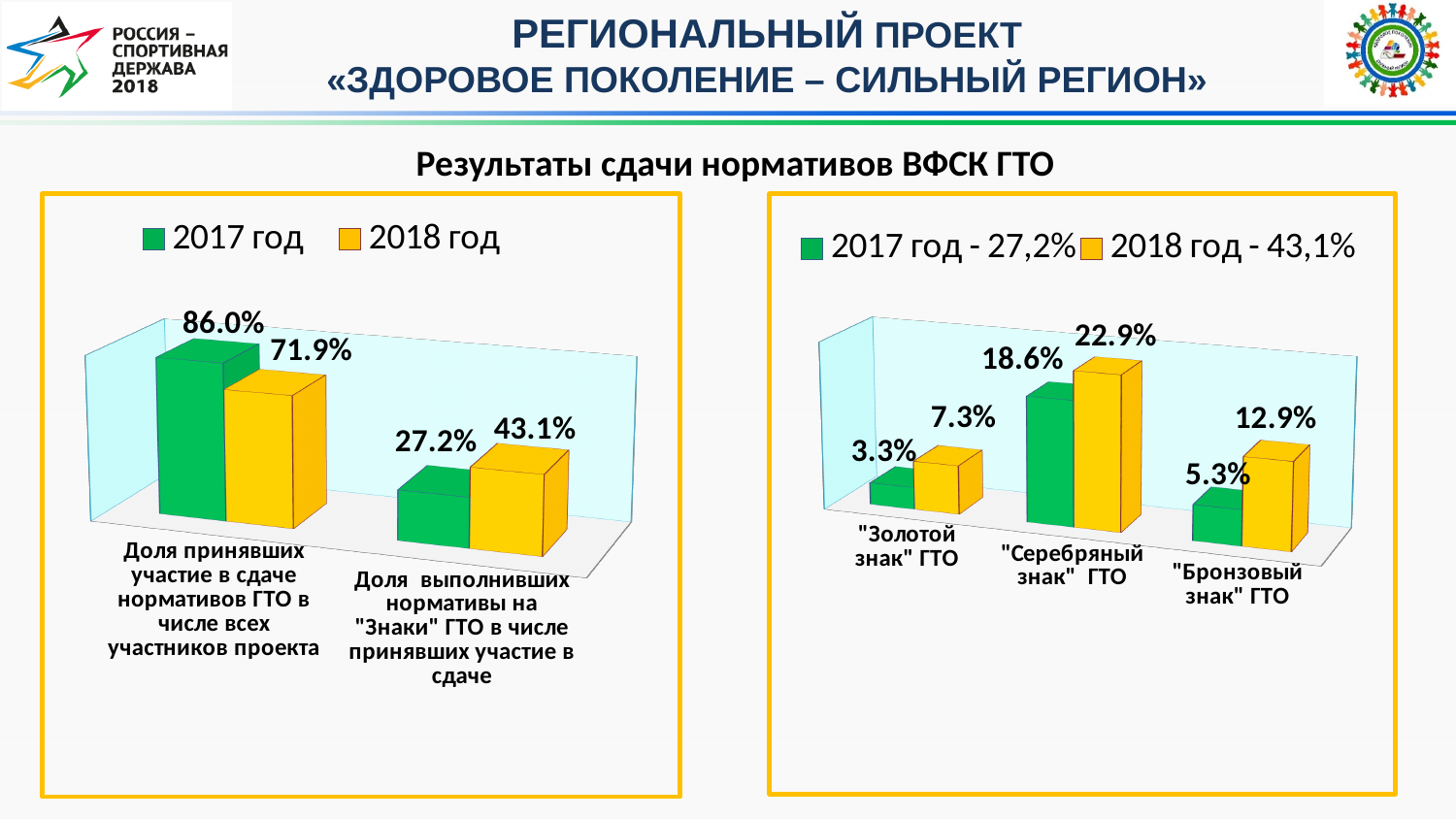
In the right chart, which category has the lowest 2017 год value? "Золотой знак" ГТО What type of chart is the right chart? Bar chart In the left chart, what is the difference between the 2017 год and 2018 год values for "Доля принявших участие в сдаче нормативов ГТО в числе всех участников проекта"? 14.1% How many categories are shown in the right chart? 3 In the left chart, which year has the larger value for "Доля выполнивших нормативы на "Знаки" ГТО"? 2018 год In the left chart, what is the 2018 год value for "Доля выполнивших нормативы на "Знаки" ГТО в числе принявших участие в сдаче"? 43.1% In the right chart, what is the difference between the 2018 год and 2017 год values for "Бронзовый знак" ГТО? 7.6% In the right chart, what is the 2017 год value for "Золотой знак" ГТО? 3.3% In the right chart, what is the 2018 год value for "Серебряный знак" ГТО? 22.9% In the right chart, which category has the highest 2018 год value? "Серебряный знак" ГТО In the left chart, what is the 2017 год value for "Доля принявших участие в сдаче нормативов ГТО в числе всех участников проекта"? 86.0% How many series does the legend of the left chart list? 2